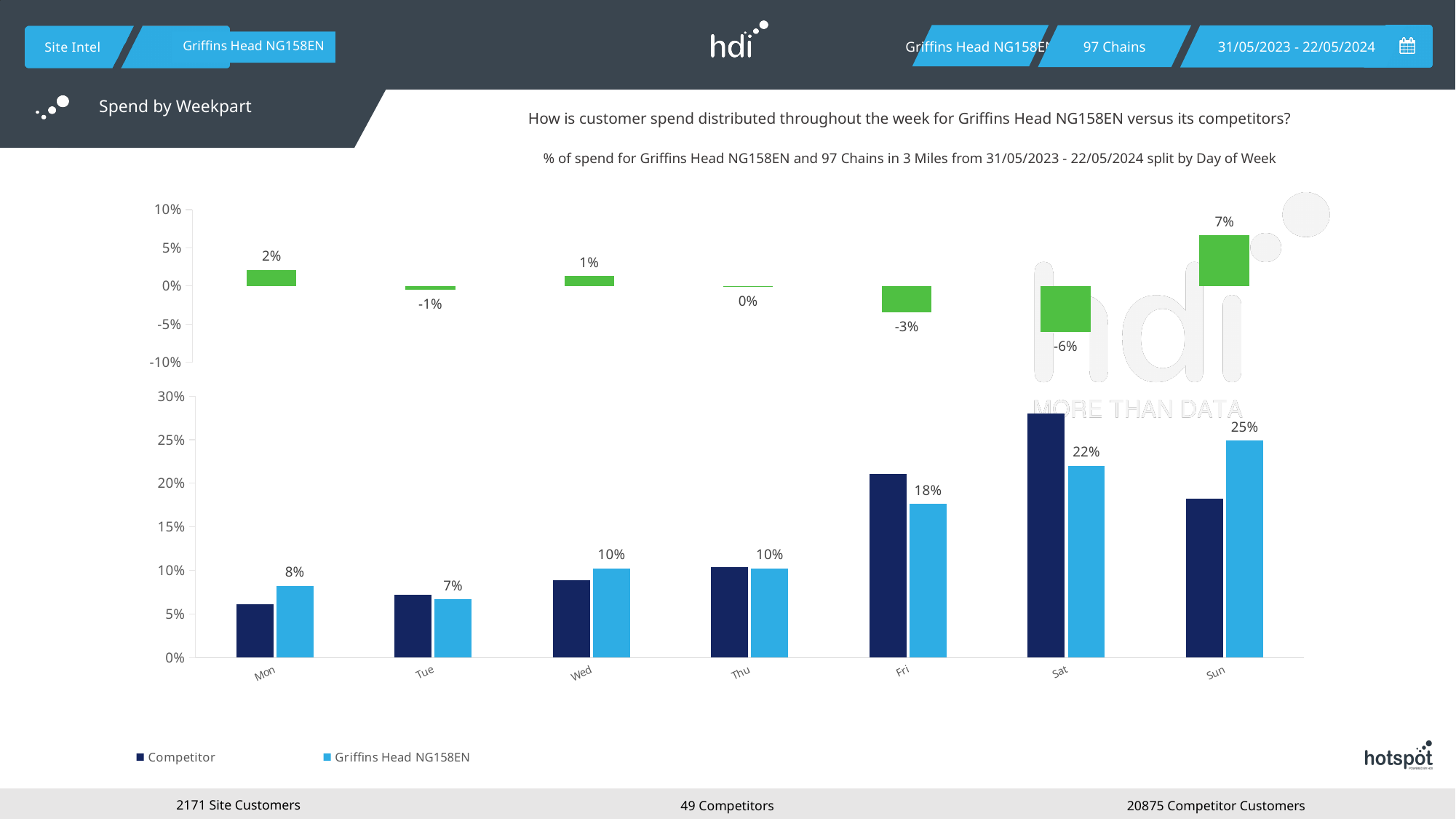
In the top chart (green bars), what is the value for Fri? -3% In the bottom chart, what is the value for Griffins Head NG158EN on Sun? 25% In the bottom chart, is the Competitor value for Sat greater or less than 25%? greater In the top chart (green bars), which day has the lowest value? Sat How many days of the week are shown on the x axis of the bottom chart? 7 How many series does the legend of the bottom chart list? 2 In the bottom chart, what is the difference between the Griffins Head NG158EN values for Sun and Mon? 17% In the top chart (green bars), which day has the highest value? Sun In the bottom chart, is the Competitor value for Mon greater or less than 10%? less In the bottom chart, on Sat, which series has the larger value: Competitor or Griffins Head NG158EN? Competitor In the bottom chart, what is the value for Griffins Head NG158EN on Fri? 18% In the bottom chart, which day has the highest value for Griffins Head NG158EN? Sun